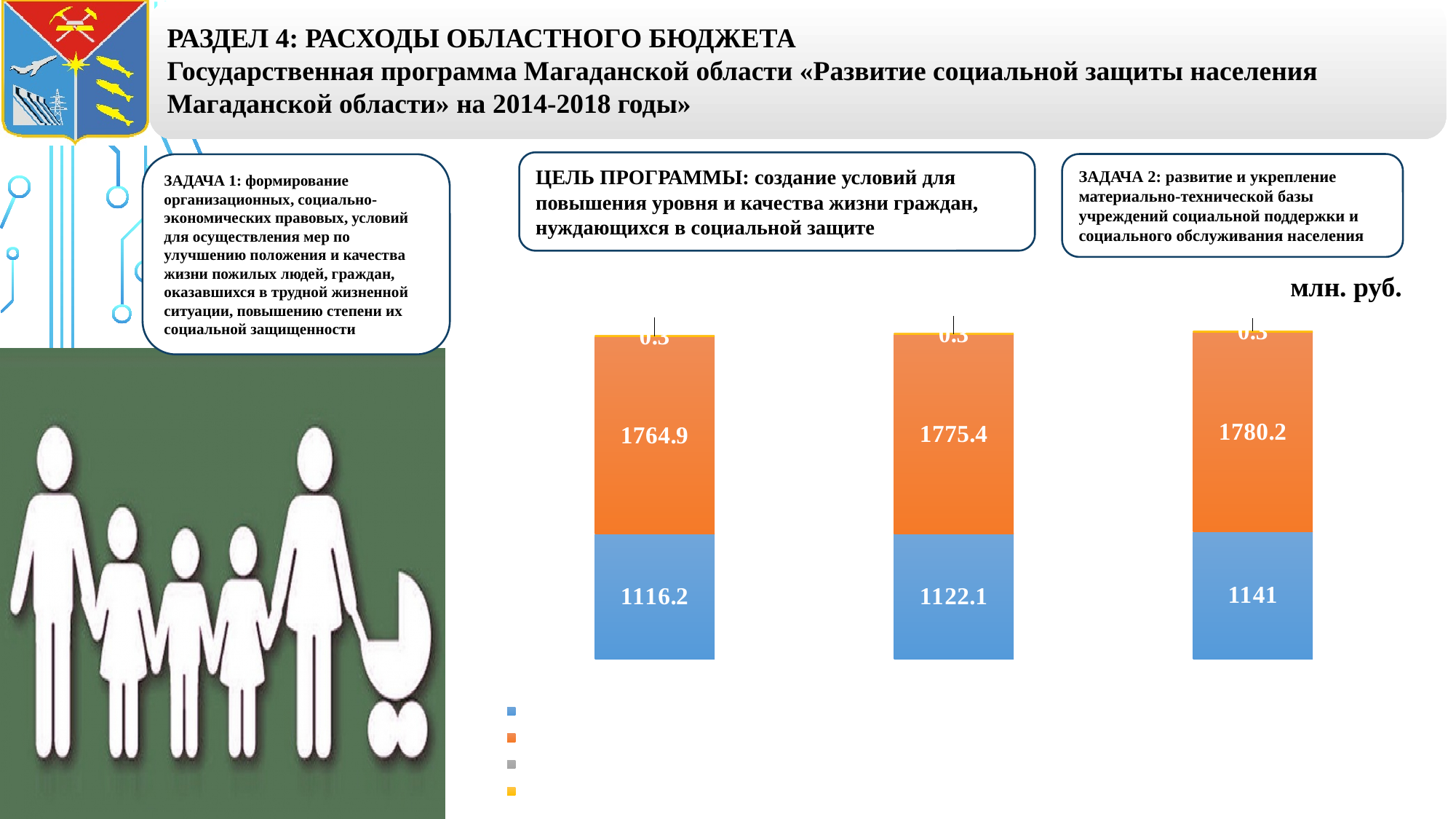
What is the value of the blue segment of the right bar? 1141 What is the difference between the blue segment of the right bar and the blue segment of the left bar? 24.8 Which bar has the highest value for the blue segment? the right bar How many bars are plotted in the chart? 3 What is the difference between the orange segment of the right bar and the orange segment of the left bar? 15.3 What kind of chart is shown on the slide? stacked bar chart What is the value of the orange segment of the middle bar? 1775.4 How many entries does the chart legend list? 4 Do the blue segment values rise or fall from the left bar to the right bar? rise What is the value of the orange segment of the right bar? 1780.2 What is the value of the blue segment of the left bar? 1116.2 Which is larger: the blue segment of the middle bar or the blue segment of the left bar? the middle bar